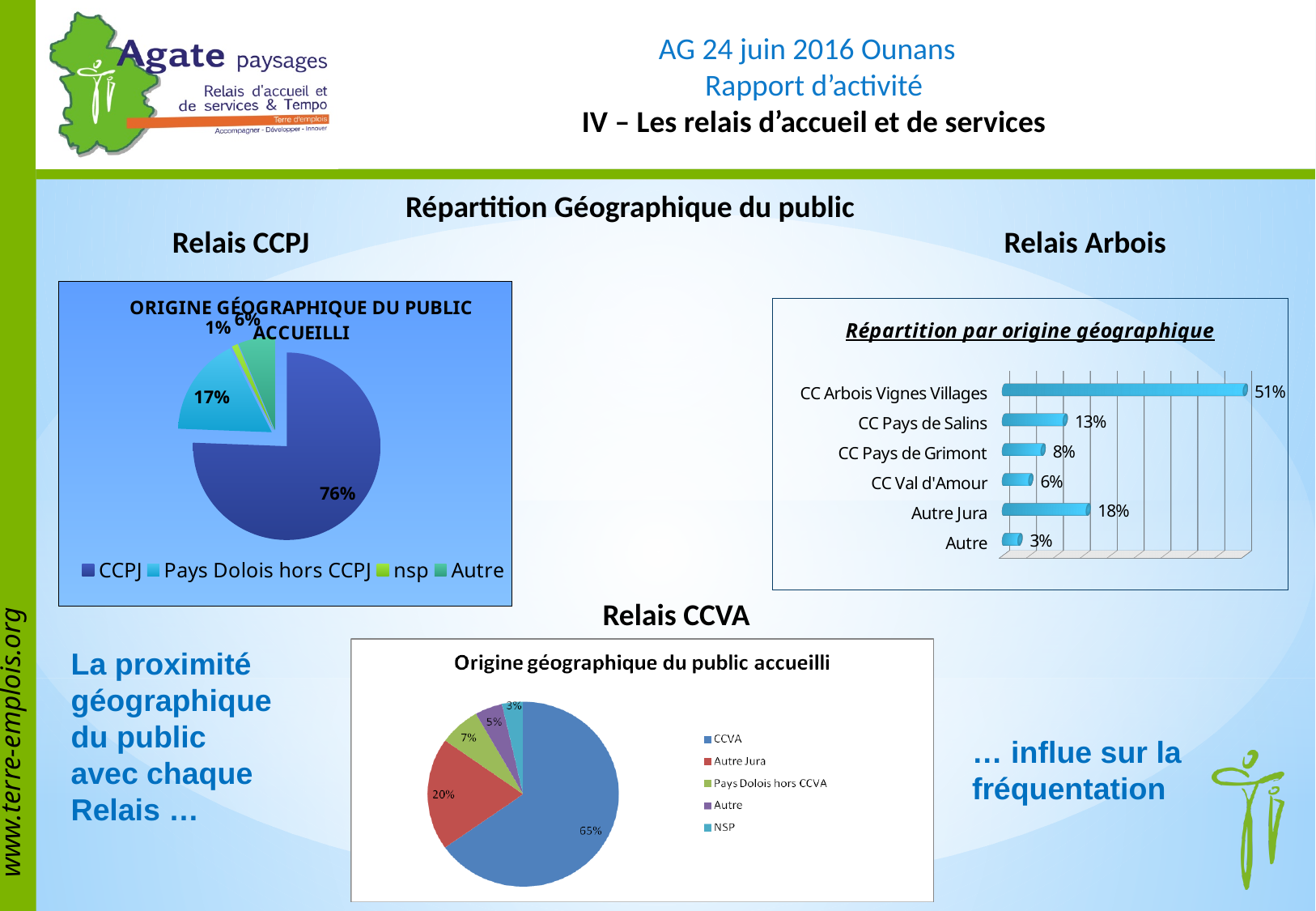
How many series does the legend of the Relais CCVA pie chart list? 5 In the Relais Arbois chart, what is the value for CC Arbois Vignes Villages? 51% In the Relais CCVA pie chart, which is larger: Pays Dolois hors CCVA or Autre? Pays Dolois hors CCVA In the Relais CCPJ pie chart, what share is labelled Pays Dolois hors CCPJ? 17% In the Relais Arbois chart, what is the value for Autre Jura? 18% In the Relais Arbois chart, which category has the lowest value? Autre In the Relais Arbois chart, what is the difference between CC Pays de Salins and CC Pays de Grimont? 5% How many categories does the legend of the Relais CCPJ pie chart list? 4 What kind of chart is the Relais Arbois chart? Bar chart In the Relais CCVA pie chart, what share is labelled Autre Jura? 20% In the Relais CCPJ pie chart, which category has the smallest share? nsp In the Relais CCPJ pie chart, what share of the public comes from CCPJ? 76%